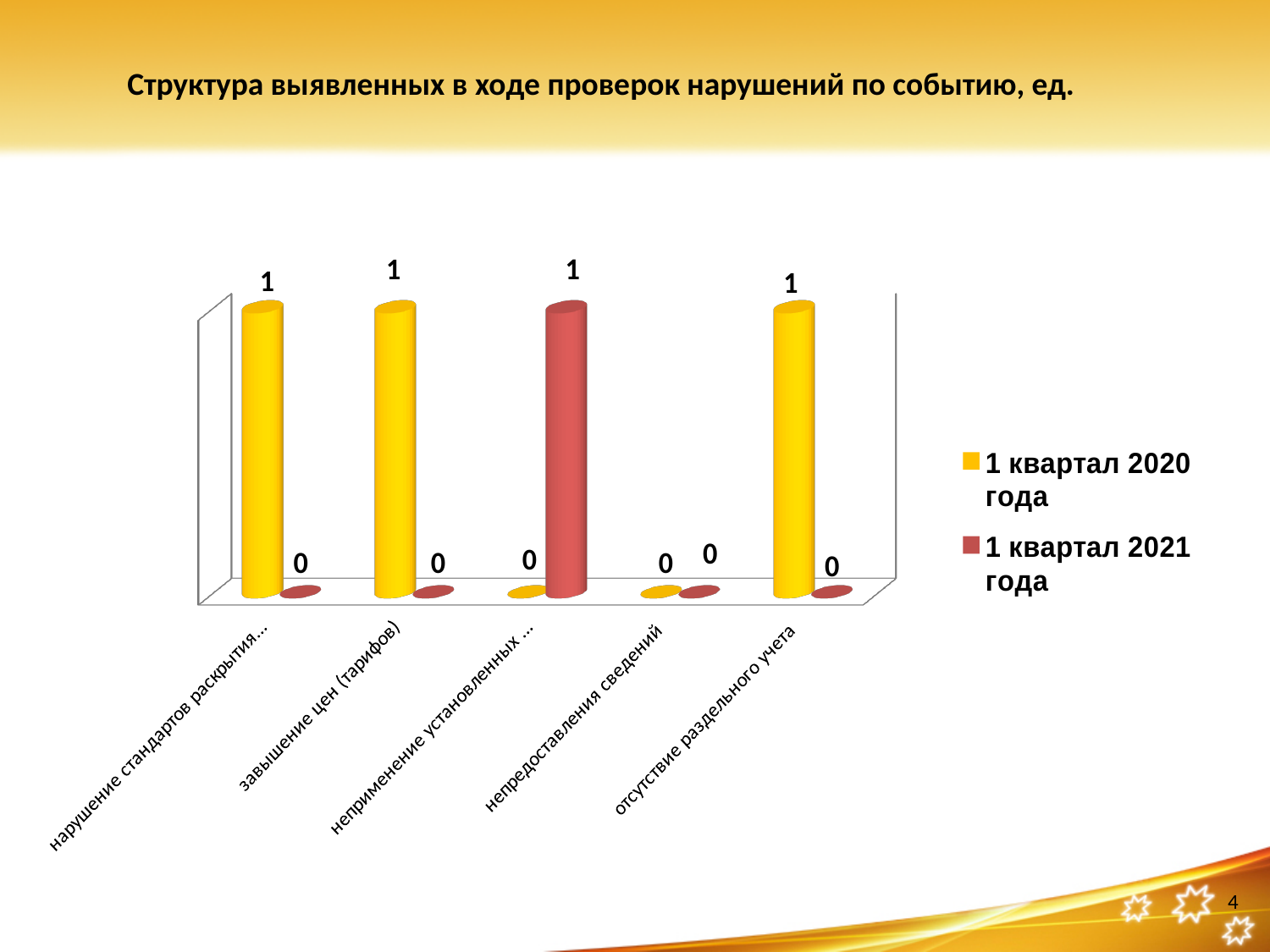
What is the value for "завышение цен (тарифов)" in the series "1 квартал 2020 года"? 1 What is the value for "завышение цен (тарифов)" in the series "1 квартал 2021 года"? 0 How many series does the legend list? 2 What is the value for "отсутствие раздельного учета" in the series "1 квартал 2020 года"? 1 What is the value for "непредоставления сведений" in the series "1 квартал 2021 года"? 0 What kind of chart is shown on the slide? bar chart What is the title of the chart on the slide? Структура выявленных в ходе проверок нарушений по событию, ед. How many categories are shown on the x axis of the chart? 5 What is the value for "непредоставления сведений" in the series "1 квартал 2020 года"? 0 Which colour represents the series "1 квартал 2021 года" in the chart? red What is the difference between the "1 квартал 2020 года" and "1 квартал 2021 года" values for "завышение цен (тарифов)"? 1 Which is larger for "отсутствие раздельного учета": the value for "1 квартал 2020 года" or for "1 квартал 2021 года"? 1 квартал 2020 года